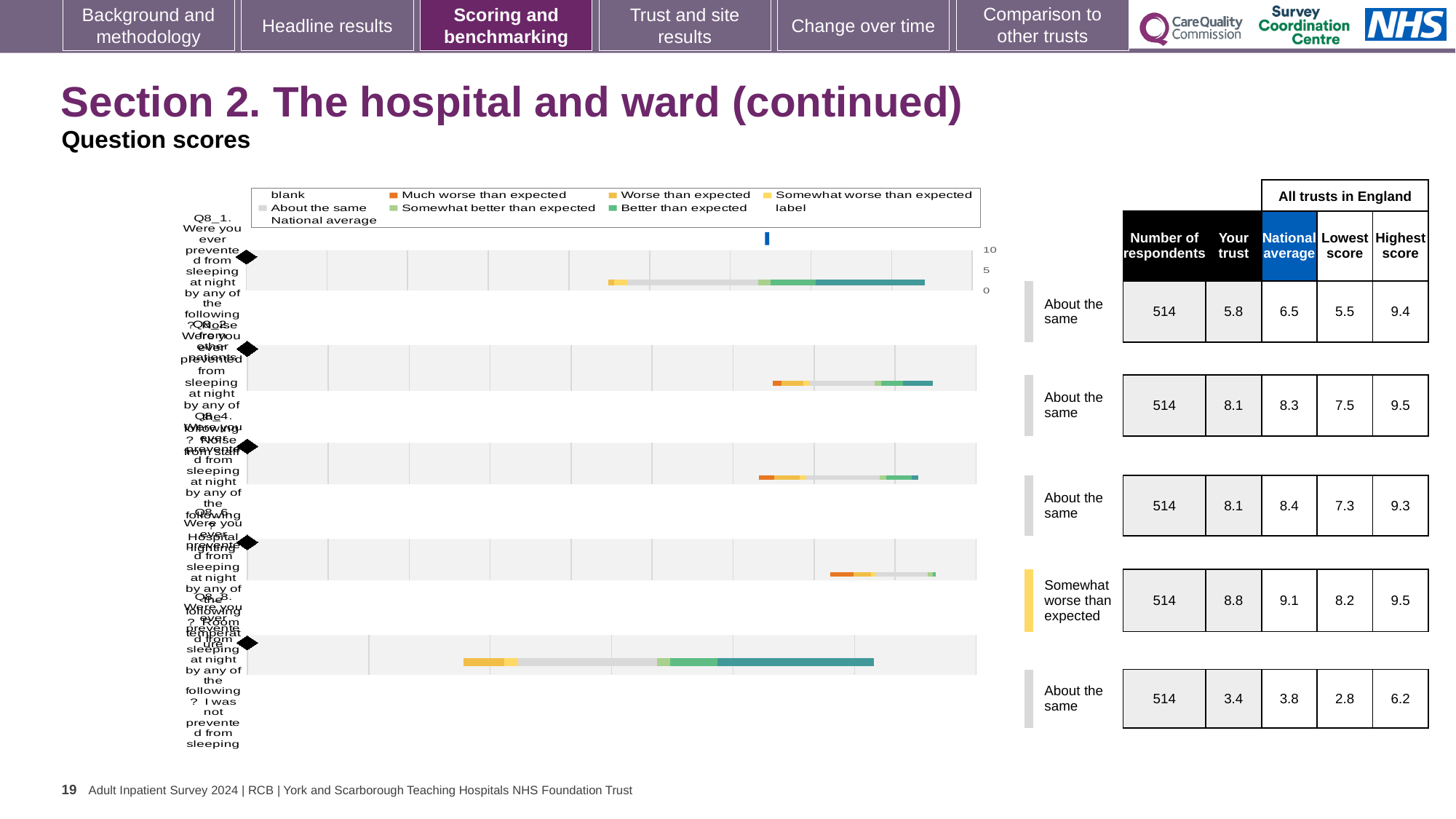
Which legend entry is shown in grey in the chart? About the same How many horizontal bars (question rows) does the chart show? 5 What kind of chart is shown on the slide? bar chart Which colour represents 'Much worse than expected' in the chart legend? orange How many entries does the chart's legend list? 9 Which bar in the chart extends furthest to the left, the top bar or the bottom bar? the bottom bar